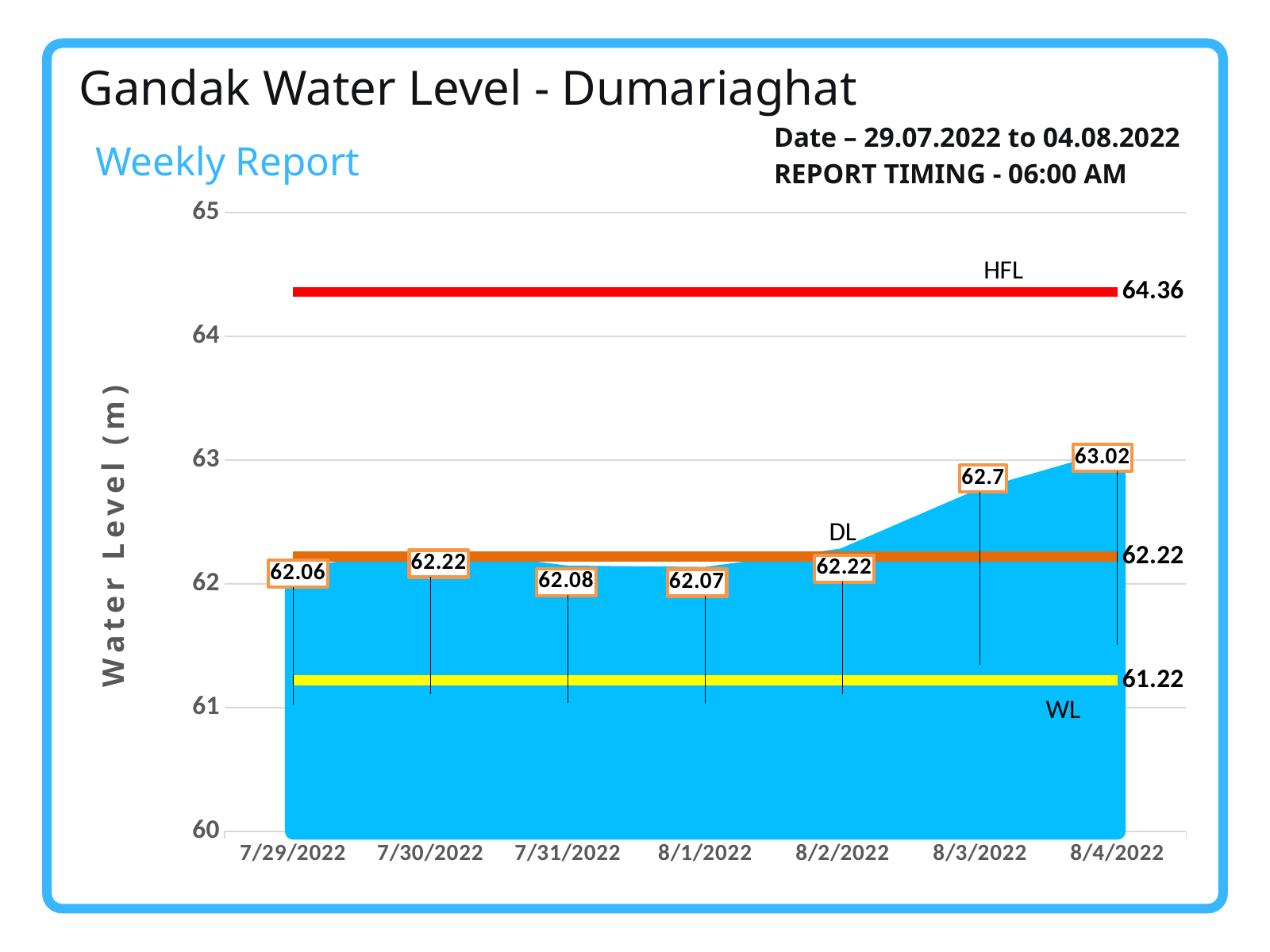
Does the water level rise or fall from 8/1/2022 to 8/4/2022? rise On which date was the water level highest? 8/4/2022 What was the water level on 8/3/2022? 62.7 Which date had a higher water level, 7/31/2022 or 8/1/2022? 7/31/2022 What is the difference between the water level on 8/4/2022 and on 8/3/2022? 0.32 What value is shown for the WL line? 61.22 What is the label on the y axis? Water Level (m) What value is shown for the HFL line? 64.36 What was the water level on 8/4/2022? 63.02 On which date was the water level lowest? 7/29/2022 How many dates are plotted on the x axis? 7 What was the water level on 7/29/2022? 62.06